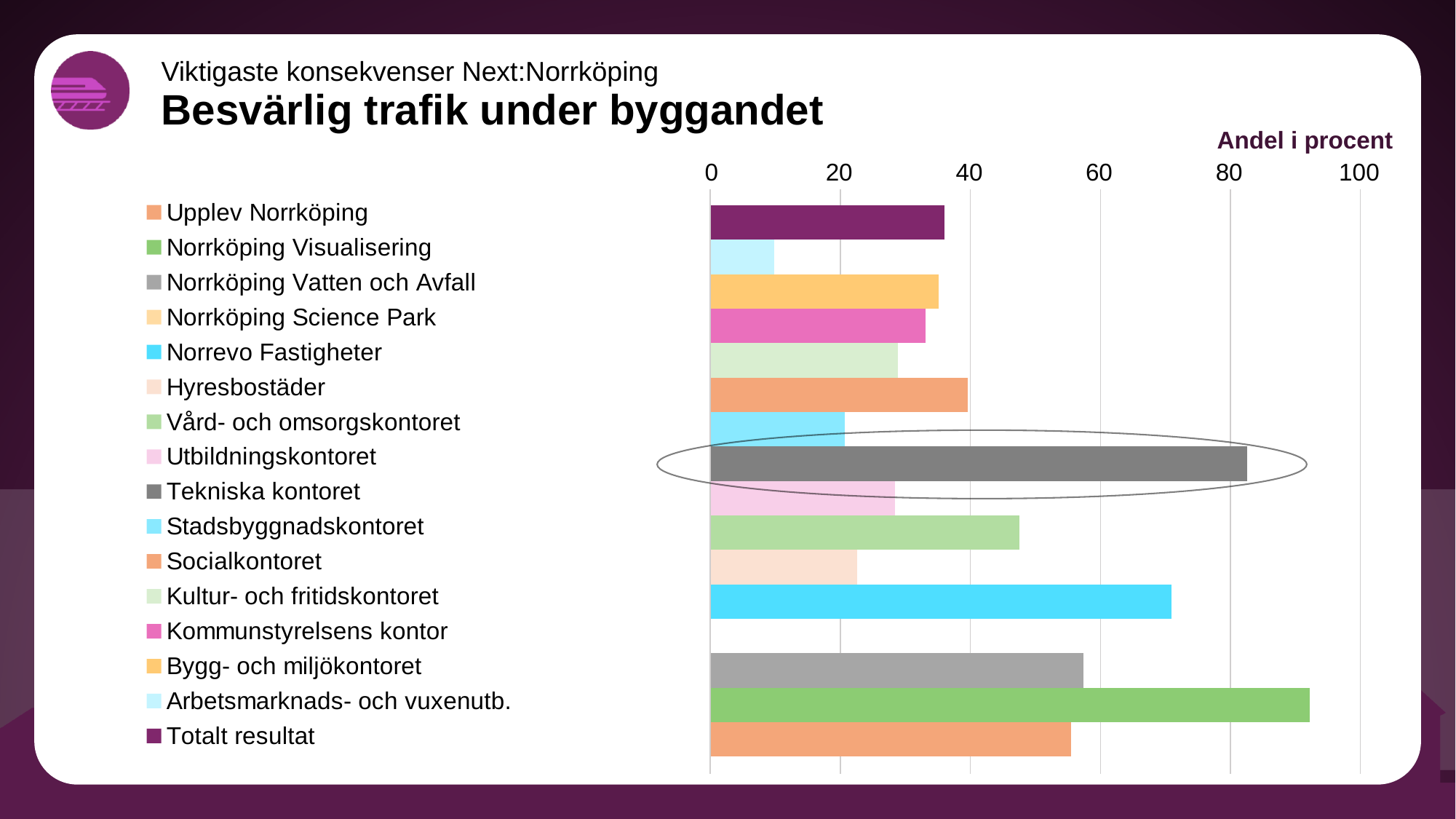
Which is larger, the value for Vård- och omsorgskontoret or the value for Utbildningskontoret? Vård- och omsorgskontoret Which category's bar is circled on the chart? Tekniska kontoret What is the axis title shown above the chart's value axis? Andel i procent Which is larger, the value for Tekniska kontoret or the value for Norrevo Fastigheter? Tekniska kontoret Is the value for Norrevo Fastigheter greater or less than 60? greater Is the value for Tekniska kontoret greater or less than 80? greater How many entries does the legend list? 16 Is the value for Vård- och omsorgskontoret greater or less than 40? greater What kind of chart is shown on the slide? bar chart Which category has the highest value? Norrköping Visualisering